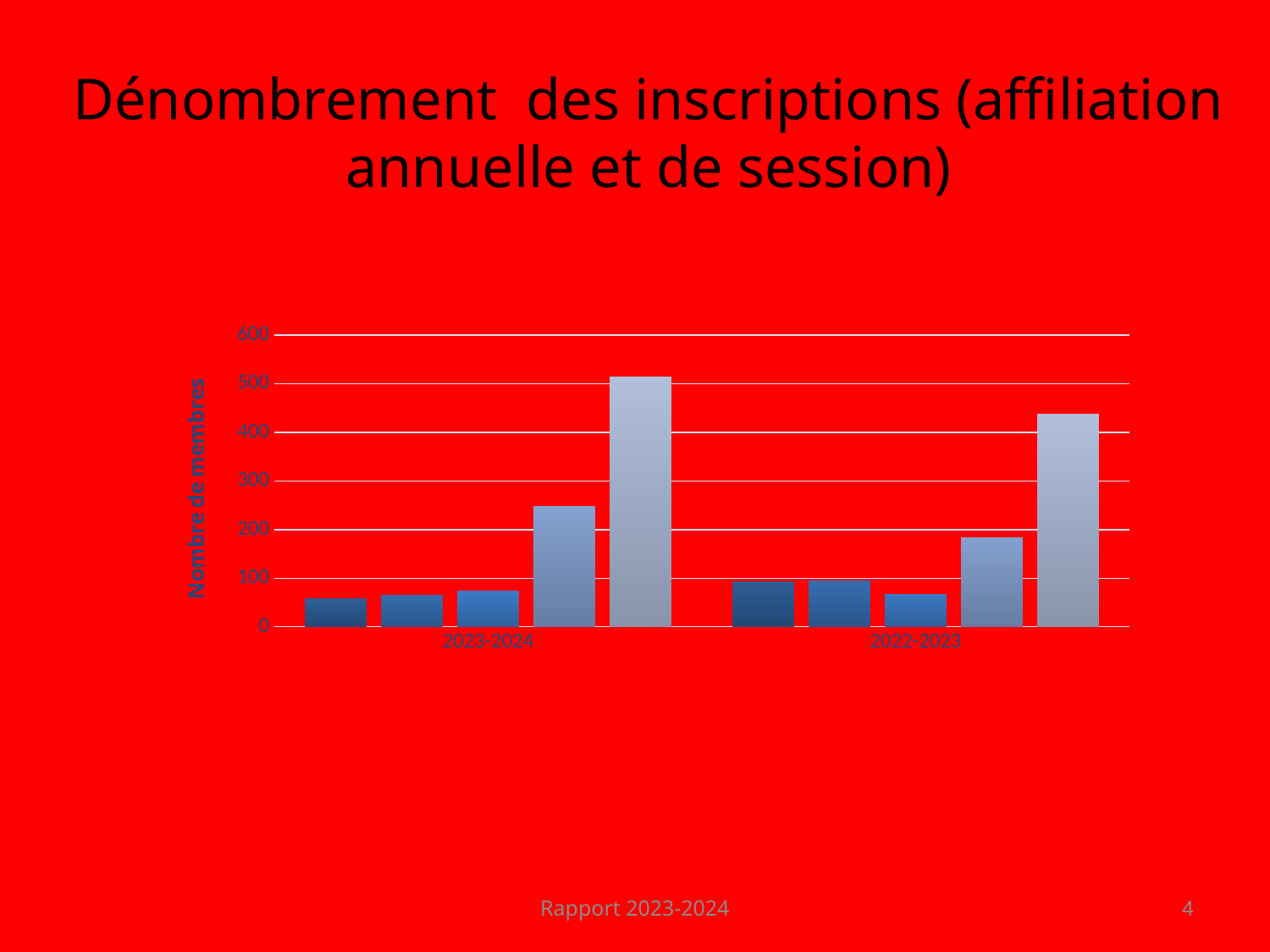
What is the title of the vertical axis of the chart? Nombre de membres What kind of chart is shown on the slide? bar chart Which is larger: the tallest bar for 2023-2024 or the tallest bar for 2022-2023? 2023-2024 What is the highest value shown on the vertical axis of the chart? 600 How many bars are plotted for the 2023-2024 category? 5 Is the value of the tallest bar in the 2022-2023 group greater or less than 400? greater Is the value of the fourth bar in the 2022-2023 group greater or less than 100? greater How many categories are shown on the x axis of the chart? 2 Is the value of the tallest bar in the 2022-2023 group greater or less than 500? less Which category contains the tallest bar in the chart? 2023-2024